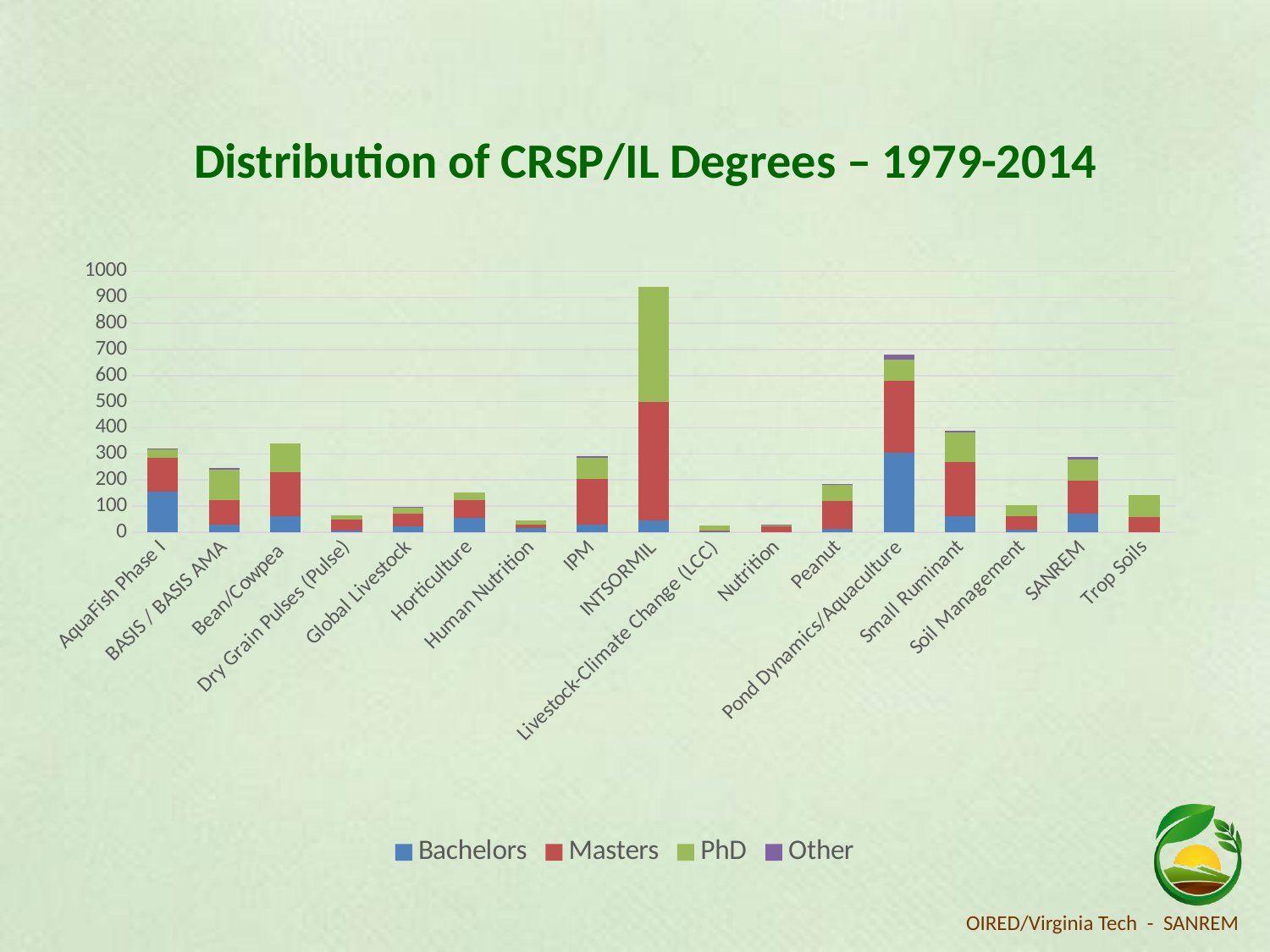
How many categories (programs) are shown on the x axis? 17 Is the total for Pond Dynamics/Aquaculture greater or less than 600? greater Is the total for INTSORMIL greater or less than 800? greater What kind of chart is shown on the slide? Stacked bar chart How many series does the legend list? 4 What is the title of the chart? Distribution of CRSP/IL Degrees – 1979-2014 Is the total for Bean/Cowpea greater or less than 300? greater Which legend entry is shown in blue? Bachelors Which has the larger total, INTSORMIL or Pond Dynamics/Aquaculture? INTSORMIL Which program has the tallest stacked bar? INTSORMIL Which has the larger total, SANREM or Soil Management? SANREM